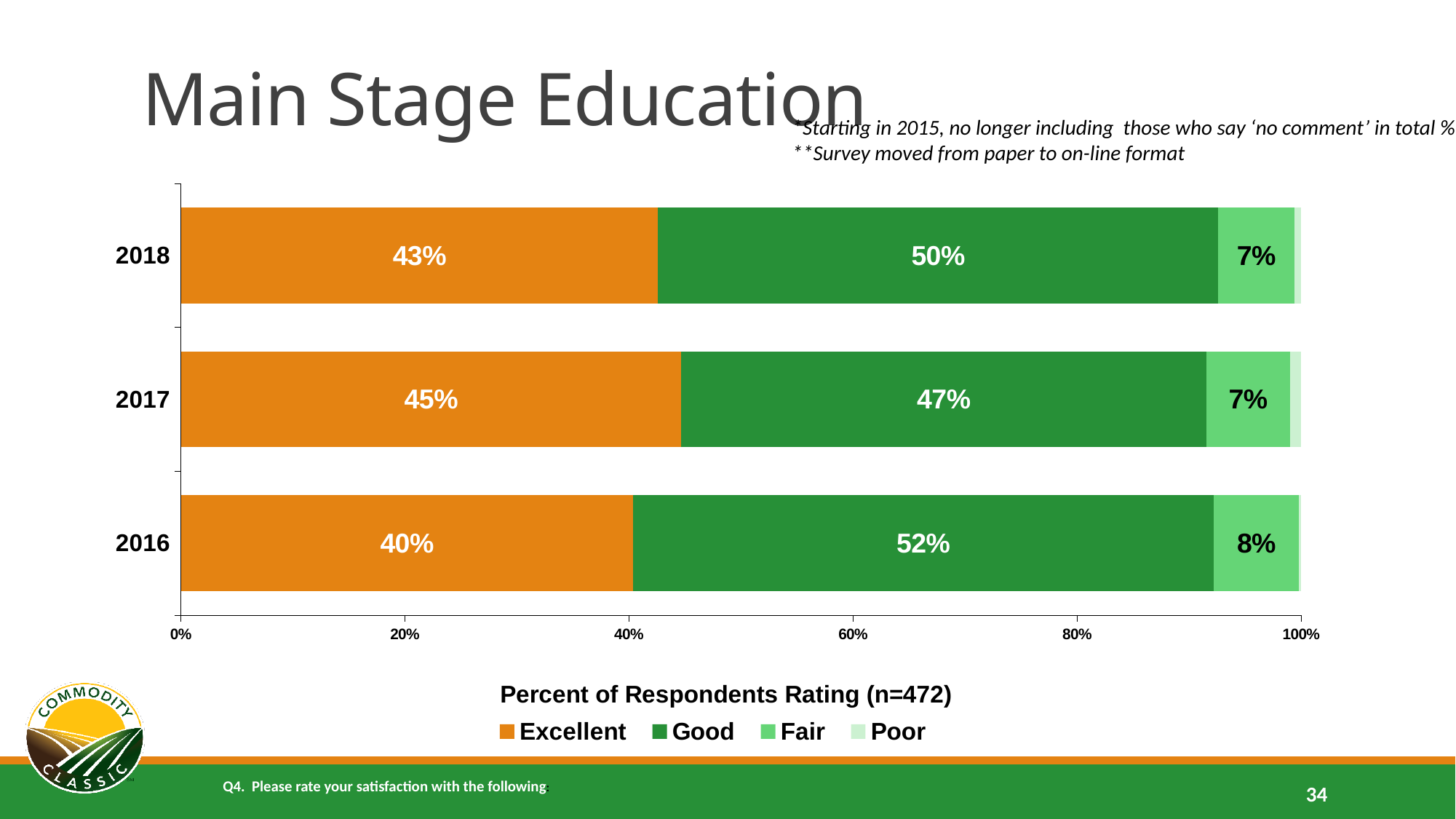
How many years are shown on the chart? 3 Is the Excellent percentage higher in 2018 or in 2016? 2018 Which year has the highest Excellent rating? 2017 What type of chart is shown on the slide? bar chart What percentage of respondents rated Main Stage Education as Good in 2016? 52% Which year has the lowest Good rating? 2017 What is the difference between the Good and Excellent percentages in 2016? 12% What is the sample size (n) stated in the chart's legend title? 472 What is the Fair rating percentage for 2017? 7% What percentage of respondents rated Main Stage Education as Excellent in 2018? 43% How many rating categories does the legend list? 4 Is the Good rating for 2017 greater or less than 40%? greater